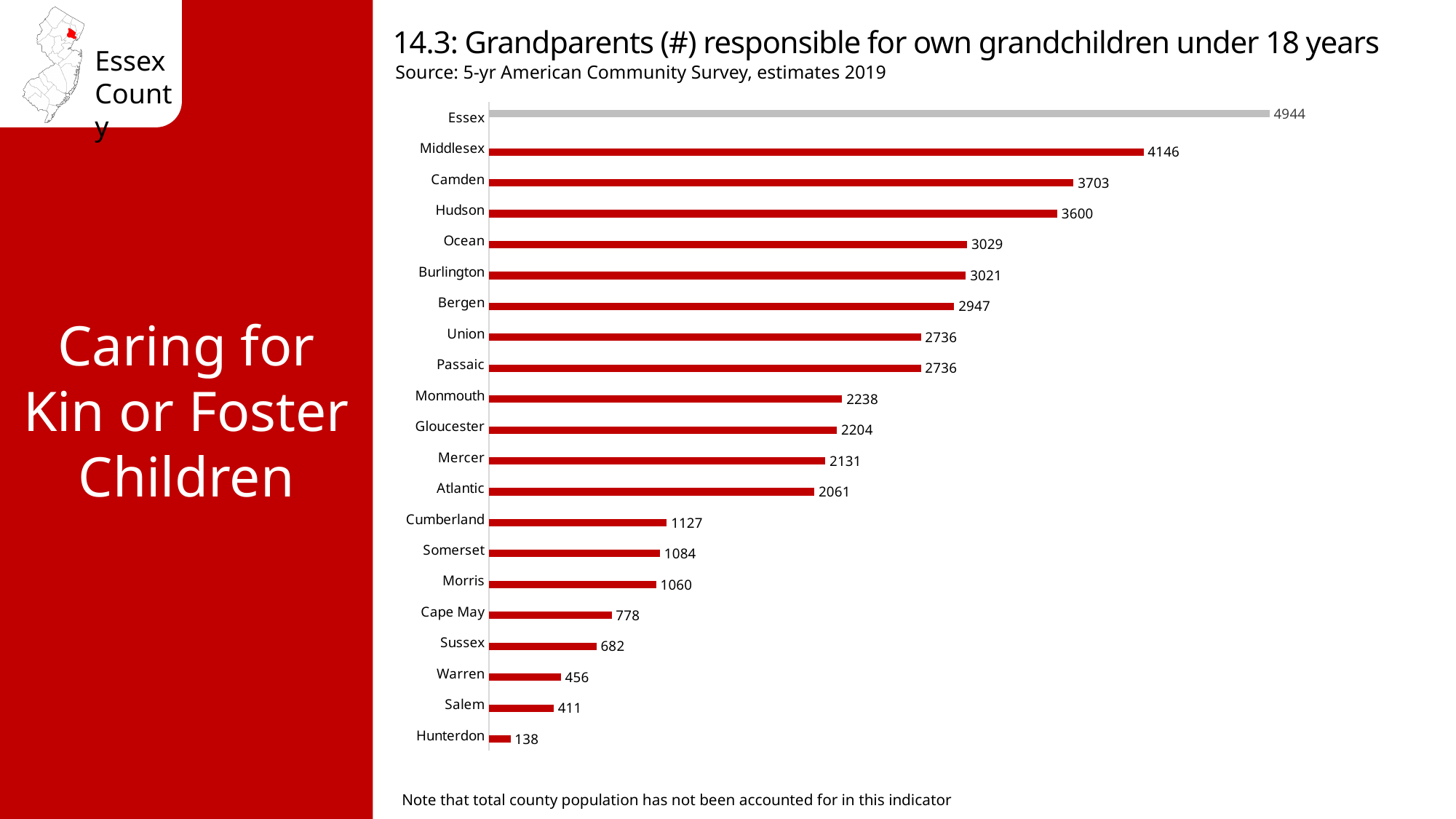
What is the difference between the values for Essex and Middlesex? 798 What is the value for Essex? 4944 How many counties are shown in the chart? 21 Which county's bar is coloured grey instead of red? Essex Which is larger, the value for Bergen or the value for Monmouth? Bergen What is the title of the chart? 14.3: Grandparents (#) responsible for own grandchildren under 18 years Which county has the highest value? Essex What is the value for Hudson? 3600 What is the value for Cumberland? 1127 What is the difference between the values for Camden and Hudson? 103 Which county has the lowest value? Hunterdon What kind of chart is shown on the slide? Bar chart